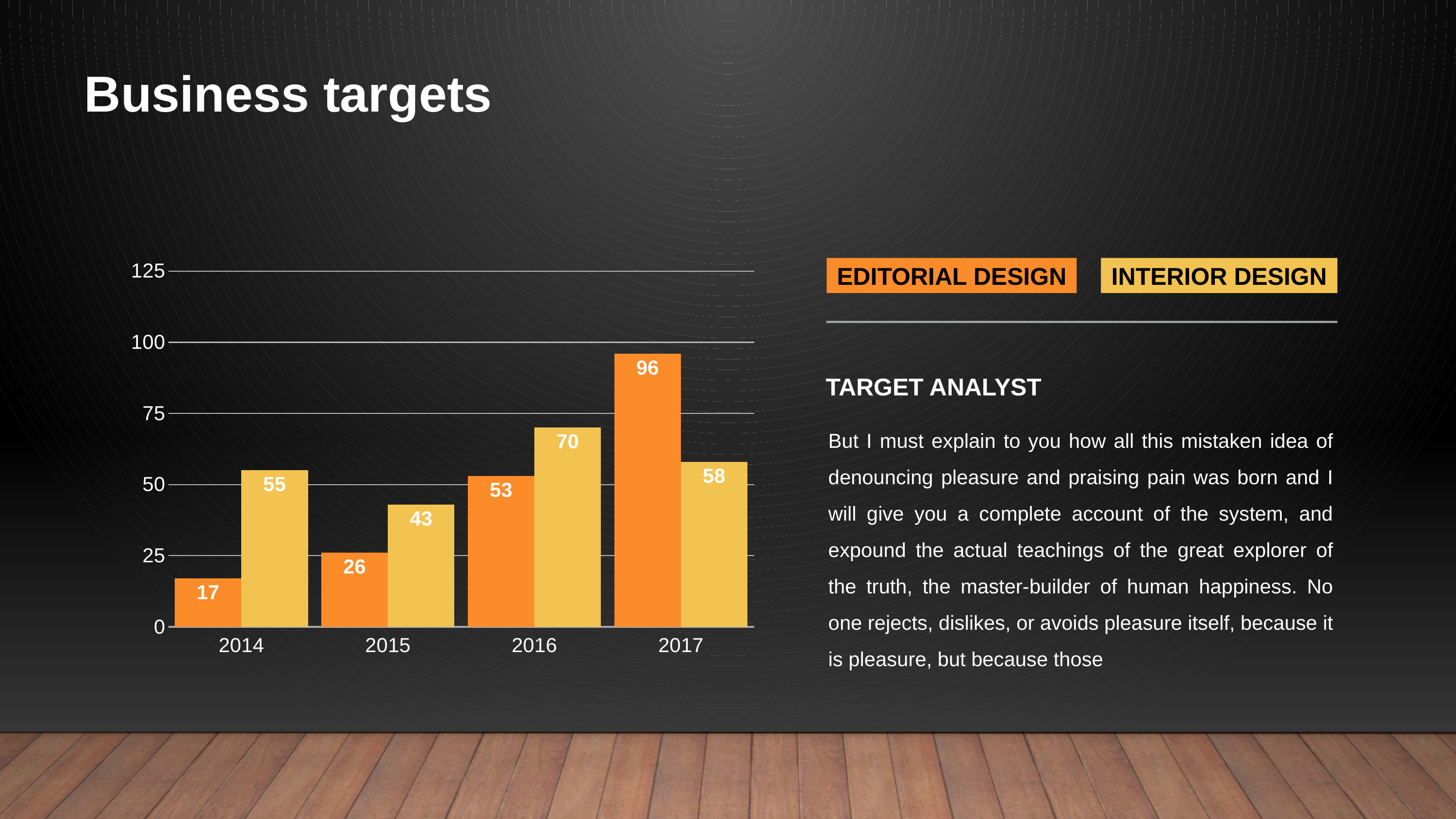
Which year has the lowest Editorial Design value? 2014 What is the difference between the Editorial Design and Interior Design values in 2017? 38 Is the Editorial Design value for 2016 greater or less than 50? greater What is the Editorial Design value for 2017? 96 Which year has the highest Interior Design value? 2016 How many years are shown on the x axis? 4 Do the Editorial Design values rise or fall from 2014 to 2017? Rise In 2016, which series has the larger value, Editorial Design or Interior Design? Interior Design What is the Interior Design value for 2015? 43 What kind of chart is shown on the slide? Bar chart How many series does the legend list? 2 What is the Editorial Design value for 2014? 17